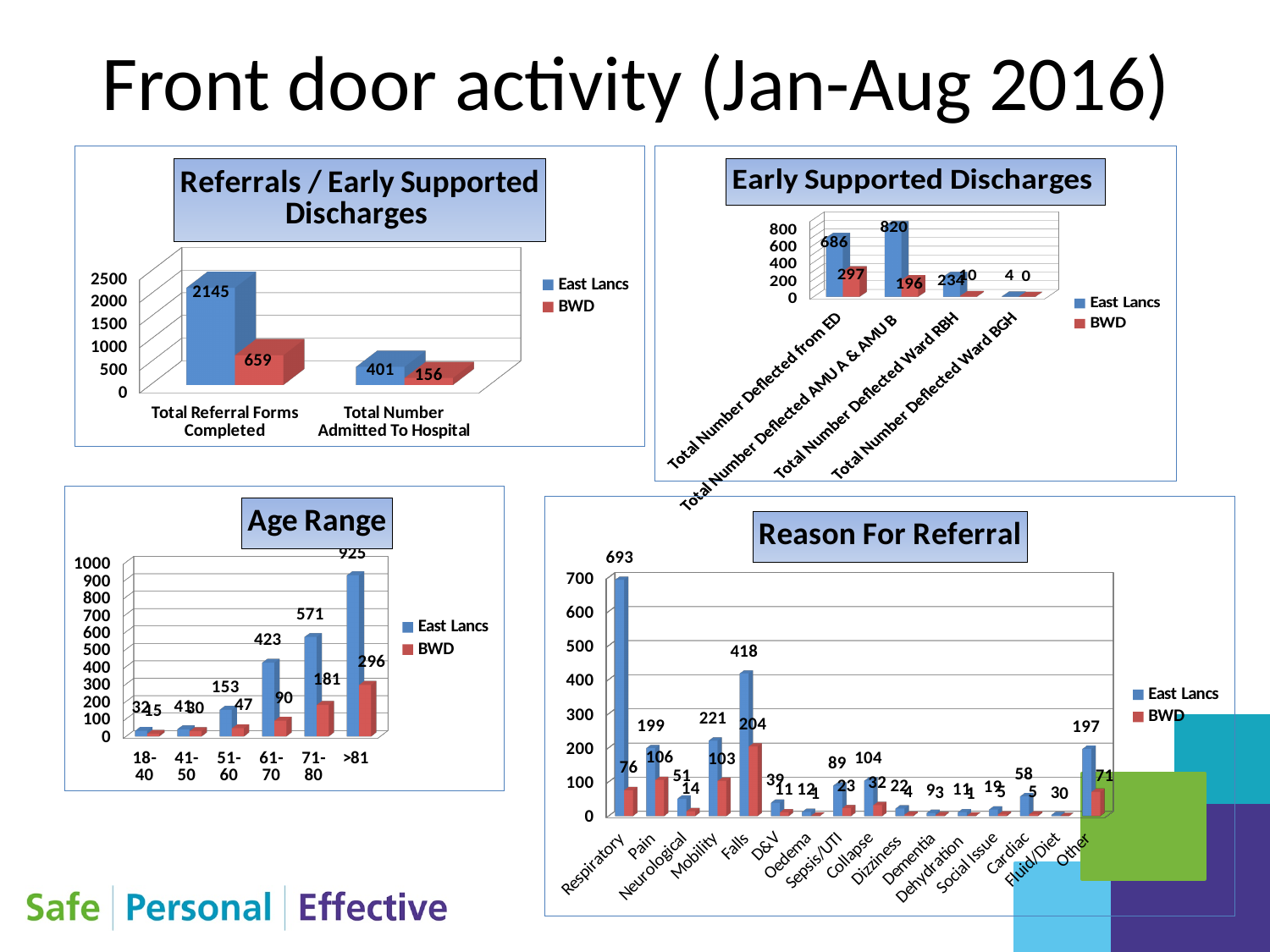
In the 'Referrals / Early Supported Discharges' chart, what is the East Lancs value for Total Referral Forms Completed? 2145 In the 'Early Supported Discharges' chart, which category has the highest East Lancs value? Total Number Deflected AMU A & AMU B In the 'Reason For Referral' chart, what is the East Lancs value for Respiratory? 693 In the 'Age Range' chart, what is the East Lancs value for the >81 age group? 925 In the 'Early Supported Discharges' chart, what is the BWD value for Total Number Deflected from ED? 297 How many series does the legend of the 'Reason For Referral' chart list? 2 In the 'Age Range' chart, what is the BWD value for the 71-80 age group? 181 In the 'Referrals / Early Supported Discharges' chart, what is the difference between the East Lancs and BWD values for Total Referral Forms Completed? 1486 In the 'Referrals / Early Supported Discharges' chart, what is the BWD value for Total Number Admitted To Hospital? 156 In the 'Early Supported Discharges' chart, what is the East Lancs value for Total Number Deflected AMU A & AMU B? 820 In the 'Age Range' chart, how many age groups are shown on the x axis? 6 In the 'Reason For Referral' chart, which is larger, the East Lancs value for Falls or the East Lancs value for Other? Falls